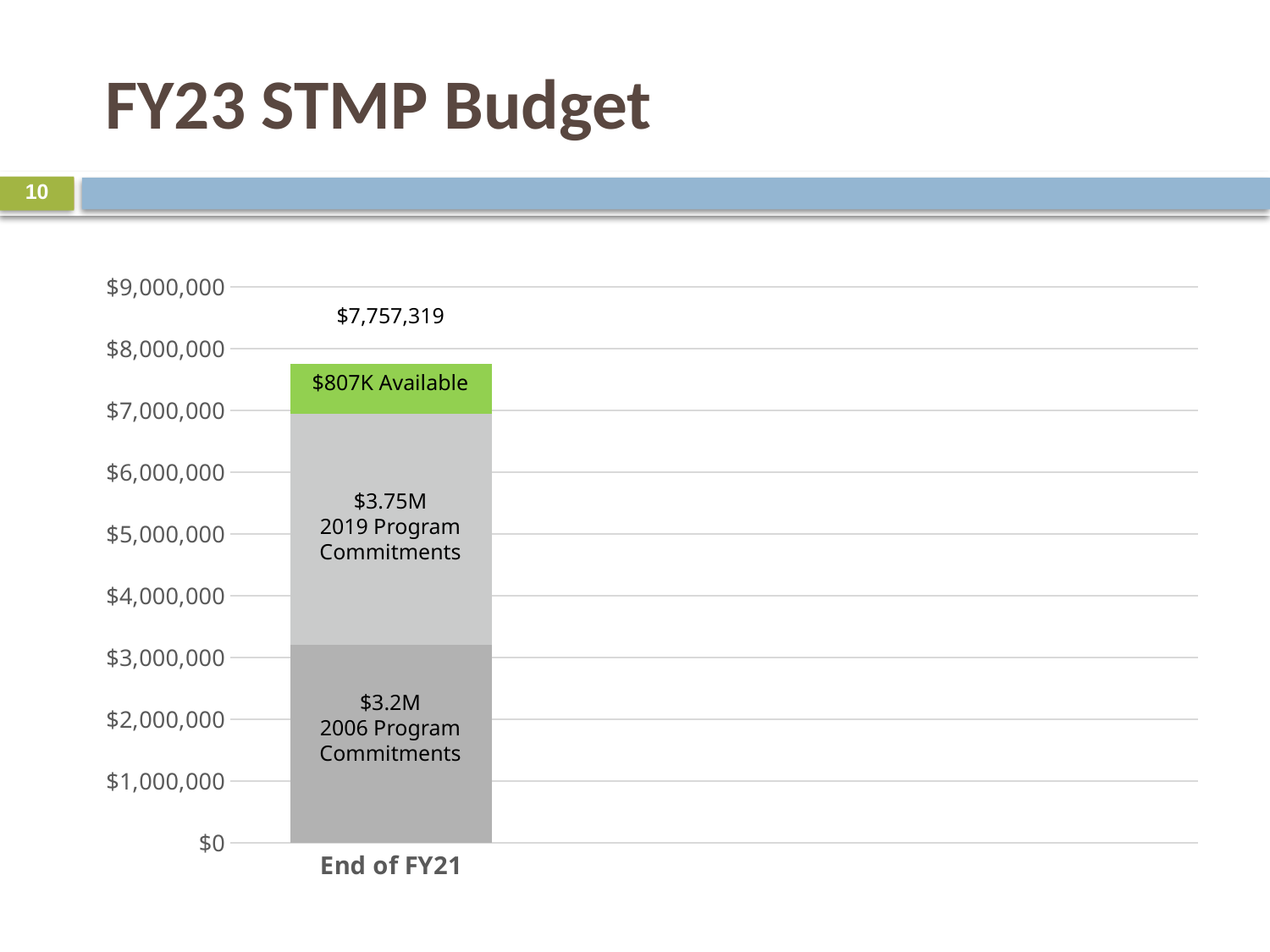
Is the total of the End of FY21 bar greater or less than $8,000,000? less How many categories are shown on the x axis? 1 Which is larger, the 2019 Program Commitments segment or the 2006 Program Commitments segment? 2019 Program Commitments What is the total value of the End of FY21 bar? $7,757,319 Which segment of the bar is the smallest? Available What is the label of the category on the x axis? End of FY21 What kind of chart is shown on the slide? Stacked bar chart What value is labelled for the 2006 Program Commitments segment? $3.2M Which segment of the bar is the largest? 2019 Program Commitments What colour is the Available segment of the bar? Green How much is labelled as Available in the bar? $807K What value is labelled for the 2019 Program Commitments segment? $3.75M